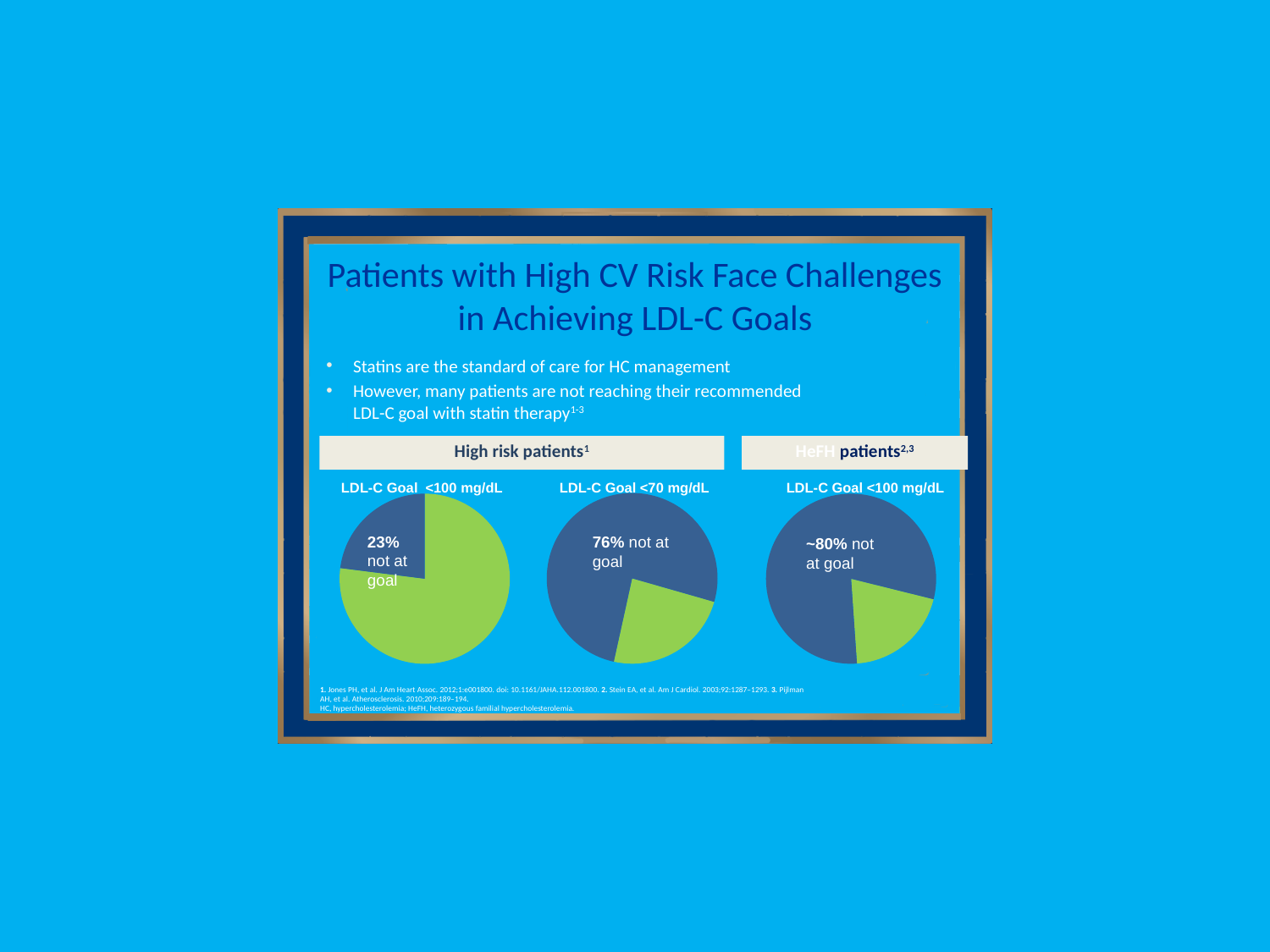
What kind of chart is used to show the proportion of patients not at goal on this slide? Pie chart In the High risk patients pie chart for LDL-C Goal <100 mg/dL, what share of the pie is at goal (the green slice)? 77% In the HeFH patients pie chart (LDL-C Goal <100 mg/dL), what percentage of patients are not at goal? ~80% What colour is used for the 'not at goal' slice in the pie charts? Dark blue In the High risk patients pie chart for LDL-C Goal <70 mg/dL, is the share of patients not at goal greater or less than 50%? greater Which of the three pie charts shows the lowest percentage of patients not at goal? High risk patients, LDL-C Goal <100 mg/dL Among the High risk patients pie charts, which LDL-C goal has the larger share of patients not at goal, <100 mg/dL or <70 mg/dL? <70 mg/dL How many pie charts are shown on the slide? 3 How many slices does each pie chart on the slide have? 2 In the High risk patients pie chart for LDL-C Goal <100 mg/dL, what percentage of patients are not at goal? 23% What is the difference in the percentage of High risk patients not at goal between the LDL-C Goal <70 mg/dL chart and the LDL-C Goal <100 mg/dL chart? 53 percentage points In the High risk patients pie chart for LDL-C Goal <70 mg/dL, what percentage of patients are not at goal? 76%